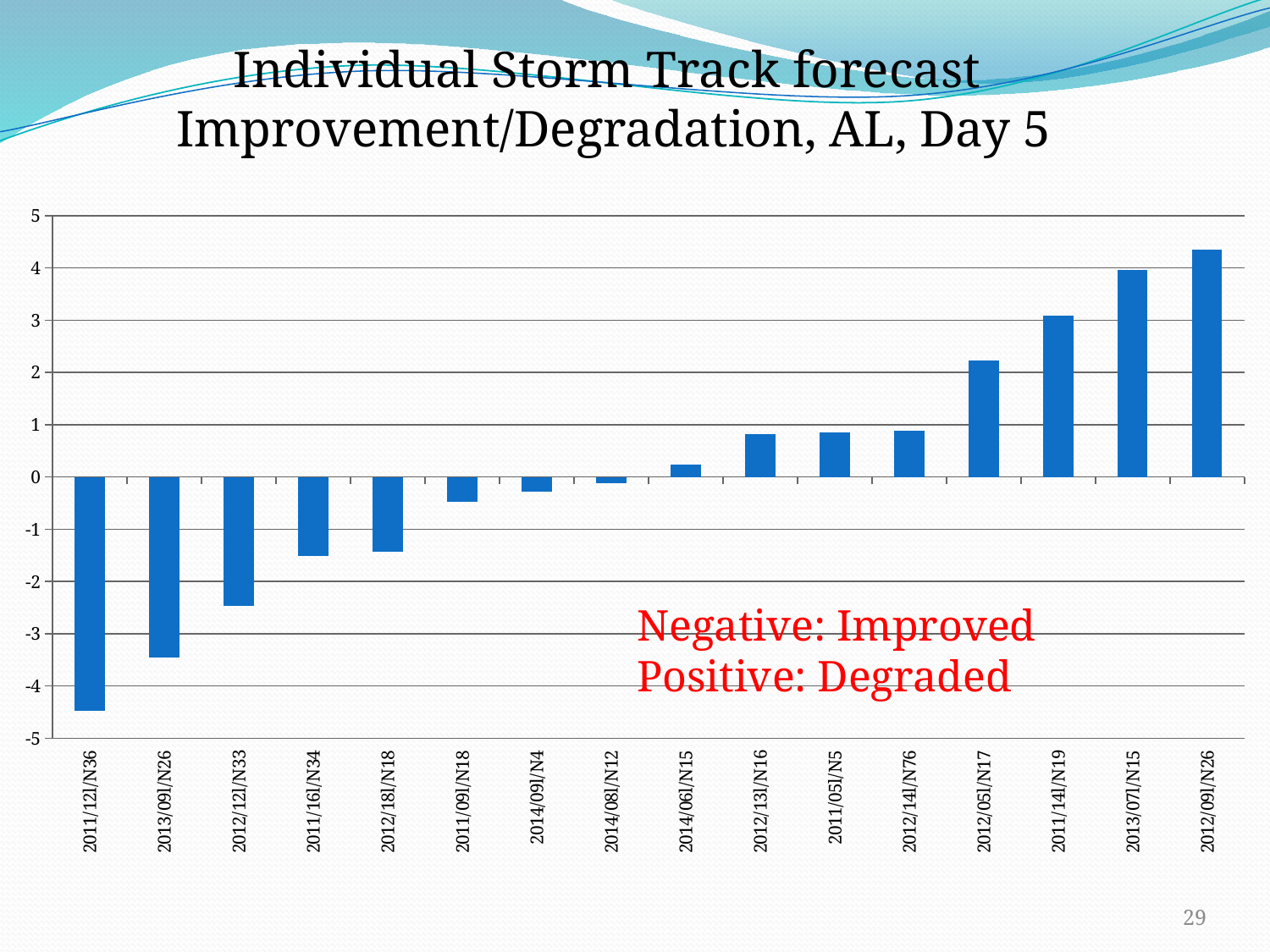
How many storm cases (bars) are plotted in the chart? 16 Which has the larger value, 2011/14l/N19 or 2012/05l/N17? 2011/14l/N19 Is the value for 2013/07l/N15 greater or less than 3? greater What kind of chart is shown on the slide? bar chart Which storm case has the lowest value in the chart? 2011/12l/N36 Is the value for 2011/12l/N36 greater or less than -4? less Which storm case has the highest value in the chart? 2012/09l/N26 How many bars in the chart have negative values? 8 Is the value for 2012/12l/N33 greater or less than -2? less Do the bar values rise or fall from left to right along the x axis? rise According to the annotation on the chart, what does a negative value indicate? Improved